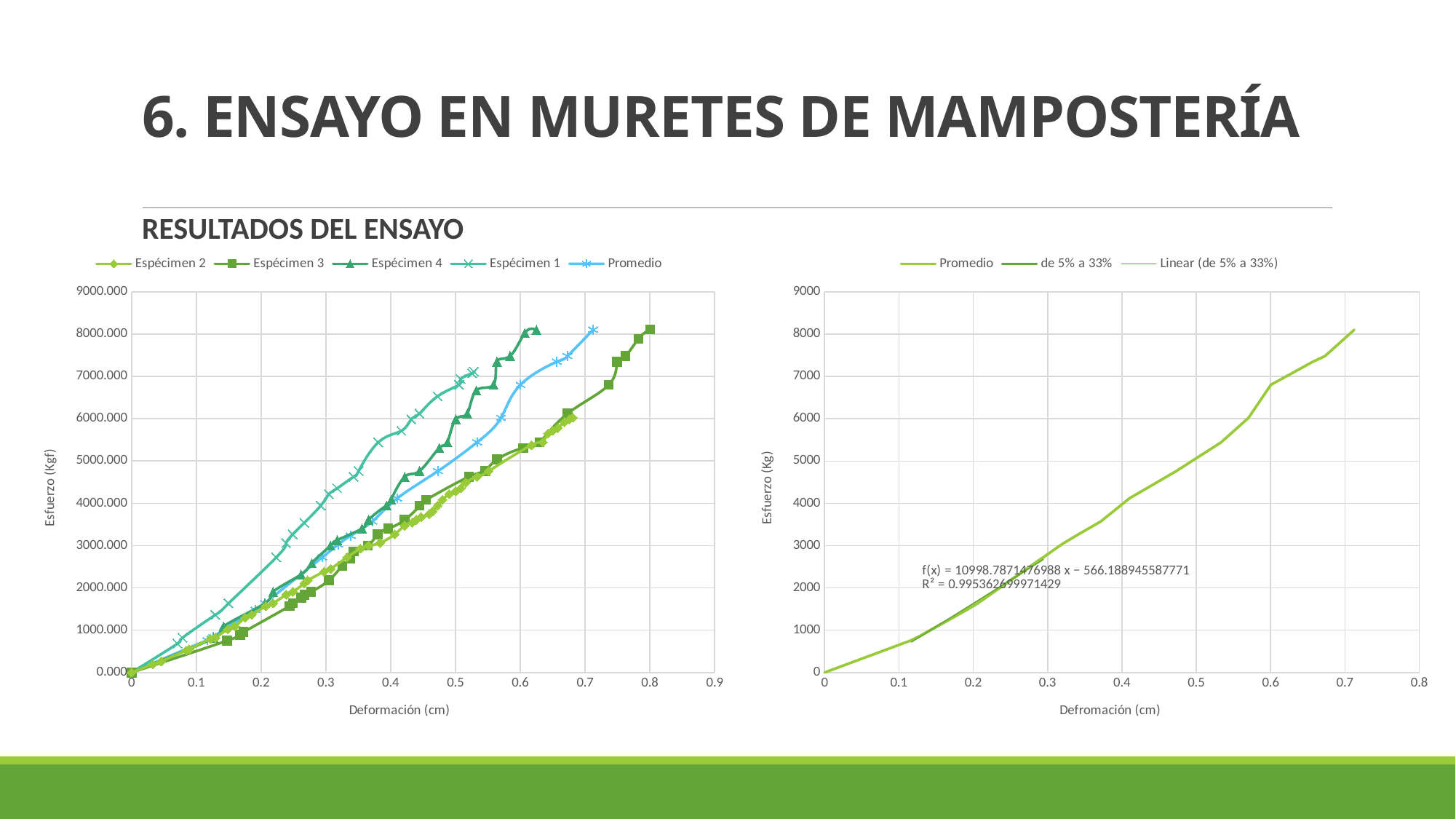
On the right chart, how many entries does the legend list? 3 On the left chart, do the values of Promedio rise or fall as deformation increases? Rise What is the y-axis title of the left chart? Esfuerzo (Kgf) On the left chart, how many series does the legend list? 5 On the left chart, is the value of Espécimen 3 at a deformation of 0.3 greater or less than 3000? less On the right chart, is the value of Promedio at a deformation of 0.6 greater or less than 6000? greater On the right chart, does the Promedio line rise or fall along the x axis? Rise On the right chart, what R² value is printed for the linear fit? 0.995362699971429 On the left chart, which series ends at the smallest deformation value? Espécimen 1 On the left chart, which series reaches the largest deformation value? Espécimen 3 What kind of chart is the left chart? Line chart On the left chart, is the value of Espécimen 1 at a deformation of 0.3 greater or less than 4000? greater